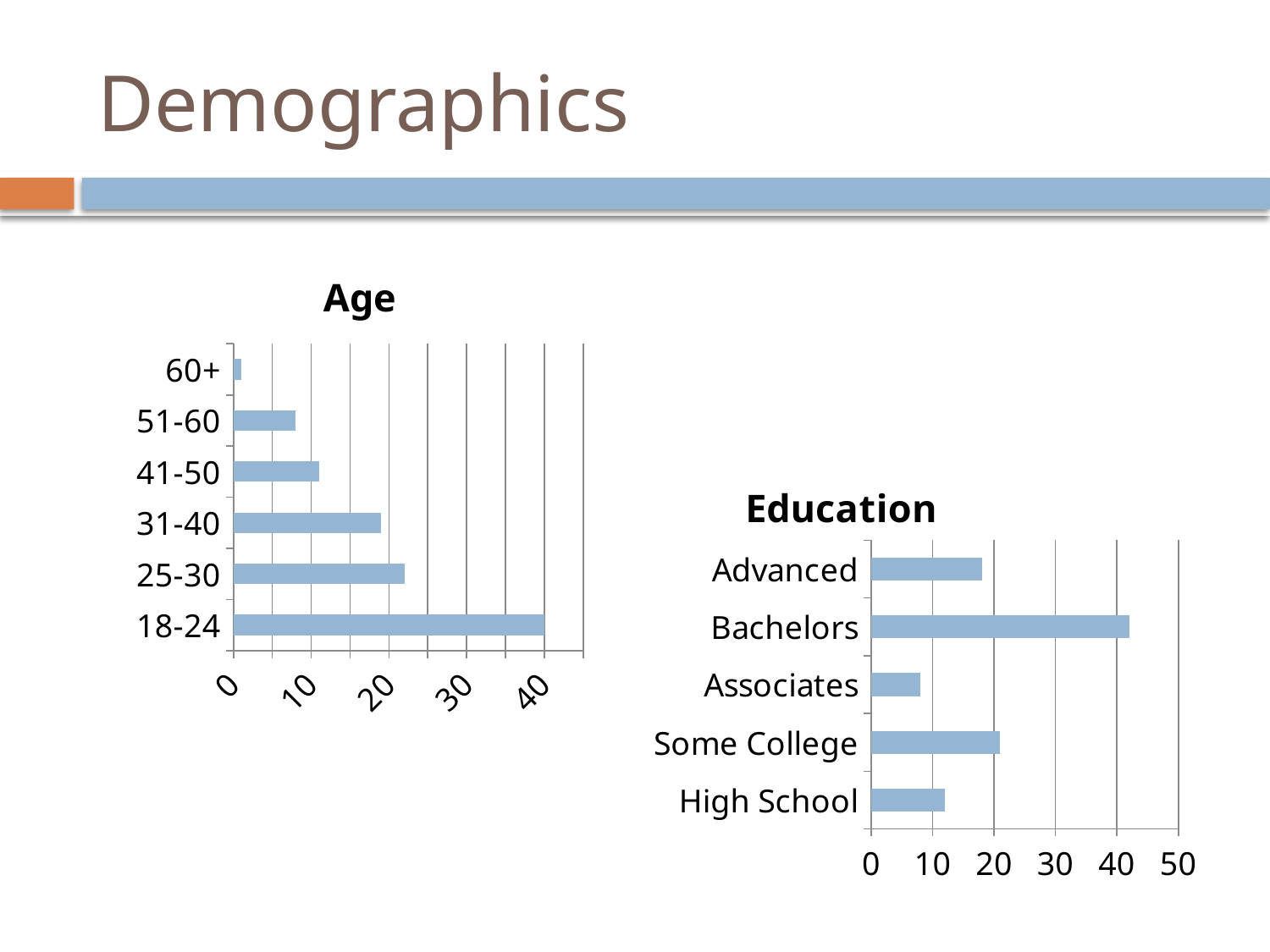
On the Education chart, which education level has the lowest value? Associates On the Education chart, is the value for Bachelors greater or less than 40? greater What kind of chart is the Age chart? bar chart How many education levels are shown on the Education chart? 5 On the Age chart, which age group has the highest value? 18-24 On the Education chart, which is larger, the value for Some College or the value for High School? Some College On the Age chart, which is larger, the value for 31-40 or the value for 41-50? 31-40 On the Age chart, is the value for 25-30 greater or less than 20? greater On the Age chart, which age group has the lowest value? 60+ How many age groups are shown on the Age chart? 6 On the Age chart, is the value for 51-60 greater or less than 10? less On the Education chart, which education level has the highest value? Bachelors